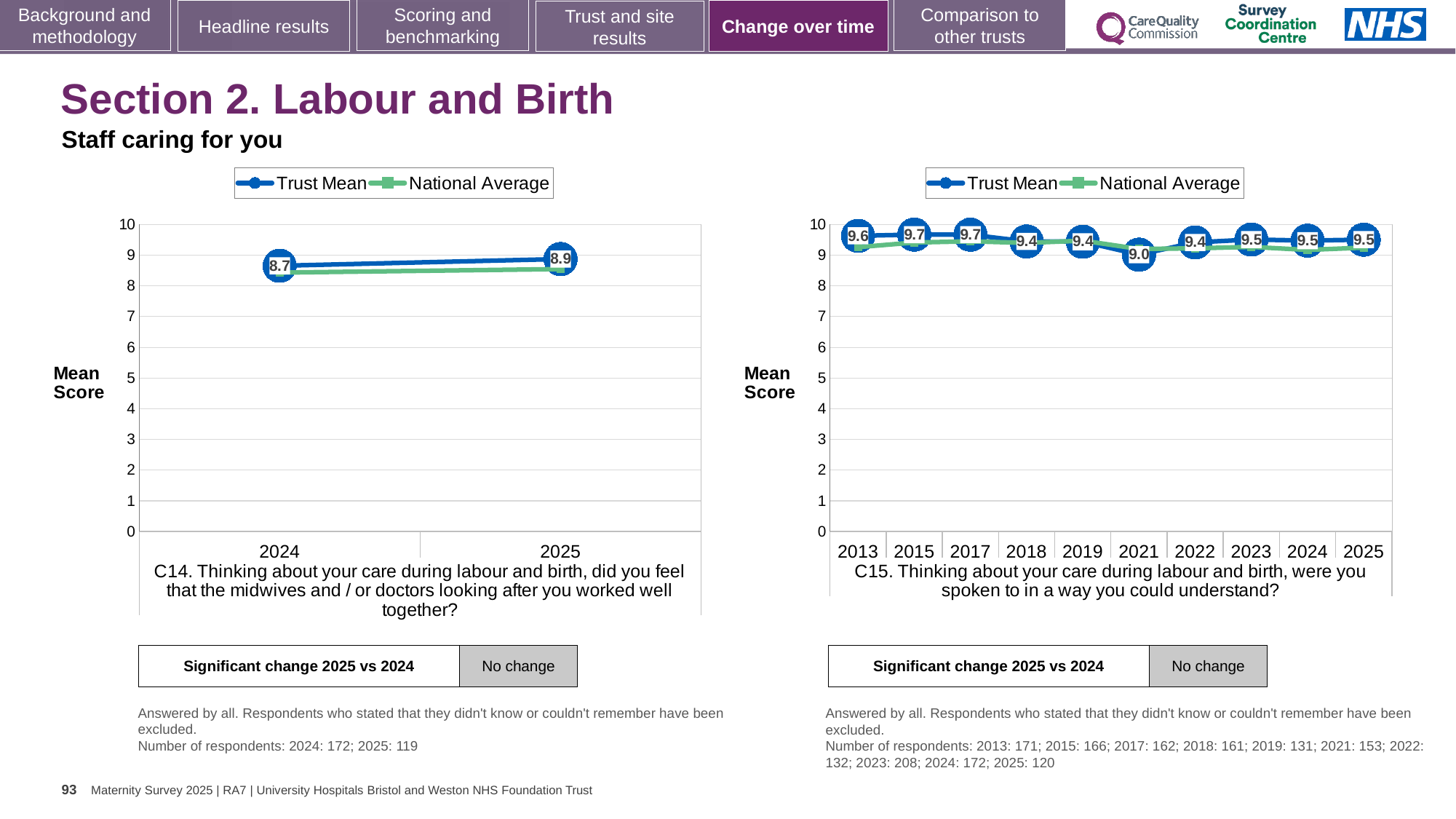
On the left chart (C14), is the National Average value for 2024 greater or less than 9? less On the left chart (C14), what is the difference between the Trust Mean values for 2025 and 2024? 0.2 On the right chart (C15), what is the Trust Mean value for 2013? 9.6 On the right chart (C15), in which year is the Trust Mean lowest? 2021 What kind of chart is the right chart (C15)? line chart On the right chart (C15), what is the Trust Mean value for 2021? 9.0 On the right chart (C15), is the Trust Mean for 2018 larger or smaller than the Trust Mean for 2021? larger On the right chart (C15), what is the difference between the Trust Mean values for 2017 and 2021? 0.7 On the right chart (C15), how many years are shown on the x axis? 10 On the left chart (C14), how many series does the legend list? 2 On the left chart (C14), what is the Trust Mean value for 2025? 8.9 On the left chart (C14), what is the Trust Mean value for 2024? 8.7